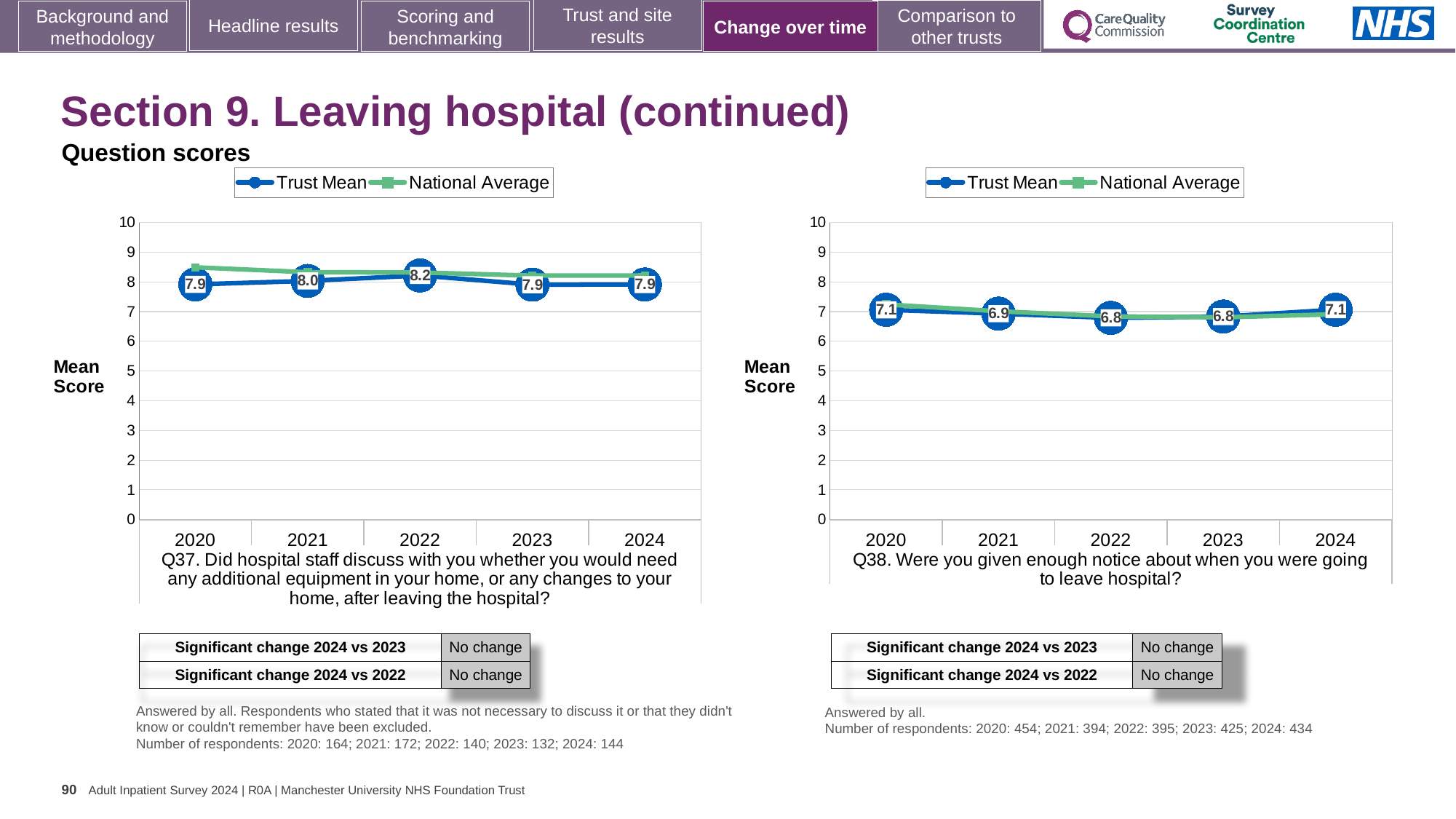
How many years are shown on the x axis of the Q38 chart on the right? 5 In the Q37 chart on the left, which year has the highest Trust Mean score? 2022 In the Q38 chart on the right, what is the difference between the Trust Mean scores for 2024 and 2022? 0.3 In the Q37 chart on the left, what is the Trust Mean score for 2022? 8.2 What kind of chart is the Q38 chart on the right? Line chart In the Q37 chart on the left, is the National Average value for 2020 greater or less than 8? greater In the Q38 chart on the right, what is the Trust Mean score for 2021? 6.9 In the Q38 chart on the right, is the National Average value for 2022 greater or less than 7? less In the Q38 chart on the right, does the Trust Mean score rise or fall from 2020 to 2022? Fall In the Q38 chart on the right, is the Trust Mean score higher in 2021 or in 2022? 2021 How many series does the legend of the Q37 chart on the left list? 2 In the Q37 chart on the left, what is the difference between the Trust Mean scores for 2022 and 2020? 0.3